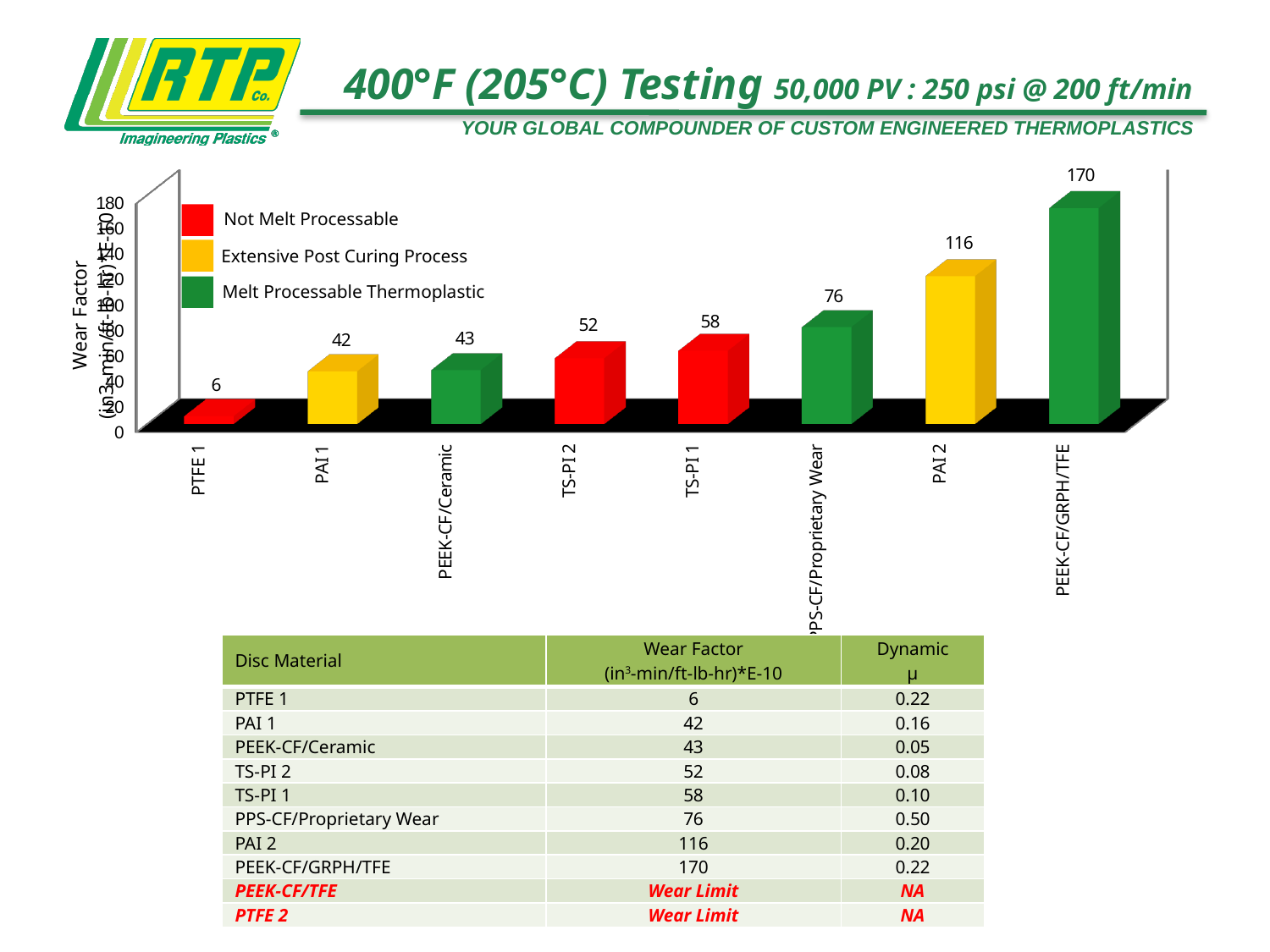
According to the legend, what does a green bar represent? Melt Processable Thermoplastic Which material has the lowest wear factor in the chart? PTFE 1 Which has a larger wear factor, PAI 1 or PEEK-CF/Ceramic? PEEK-CF/Ceramic What is the wear factor value shown for PTFE 1 in the chart? 6 What is the difference between the wear factor of TS-PI 1 and TS-PI 2? 6 What is the wear factor value shown for PPS-CF/Proprietary Wear in the chart? 76 What kind of chart is shown on the slide? Bar chart Do the wear factor values rise or fall from left to right across the chart? Rise Which material has the highest wear factor in the chart? PEEK-CF/GRPH/TFE What is the difference between the wear factor of PEEK-CF/GRPH/TFE and PAI 2? 54 How many materials are plotted as bars in the chart? 8 What is the wear factor value shown for PAI 2 in the chart? 116